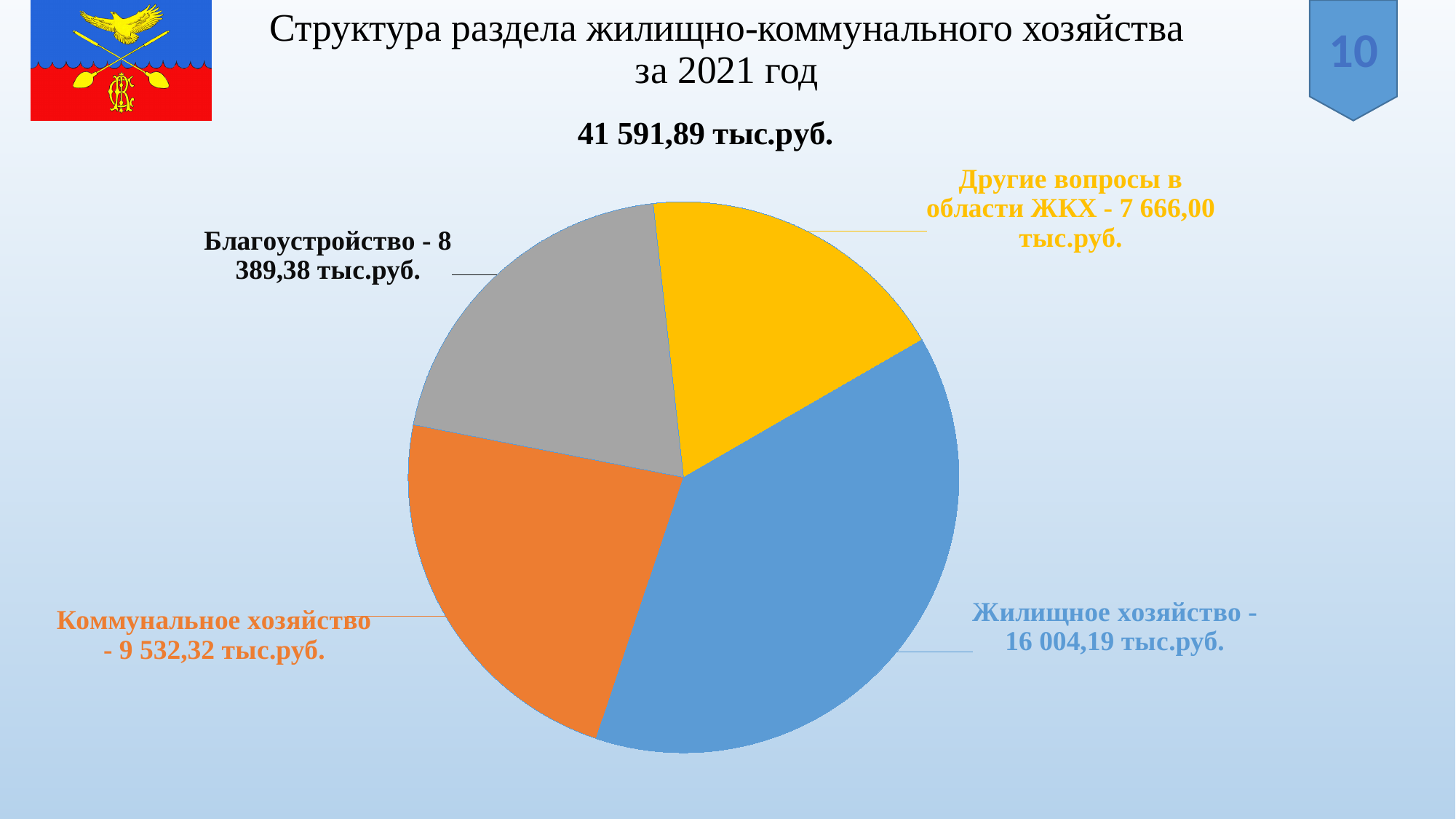
What is the total value shown above the pie chart? 41 591,89 тыс.руб. What is the value for Другие вопросы в области ЖКХ? 7 666,00 тыс.руб. What colour is the slice for Благоустройство? grey What is the value for Благоустройство? 8 389,38 тыс.руб. What is the value for Жилищное хозяйство? 16 004,19 тыс.руб. Which category has the smallest slice of the pie? Другие вопросы в области ЖКХ Which category has the largest slice of the pie? Жилищное хозяйство Which is larger, Коммунальное хозяйство or Благоустройство? Коммунальное хозяйство What is the difference between Жилищное хозяйство and Коммунальное хозяйство? 6 471,87 тыс.руб. How many slices does the pie chart have? 4 What is the value for Коммунальное хозяйство? 9 532,32 тыс.руб. What kind of chart is shown on the slide? pie chart